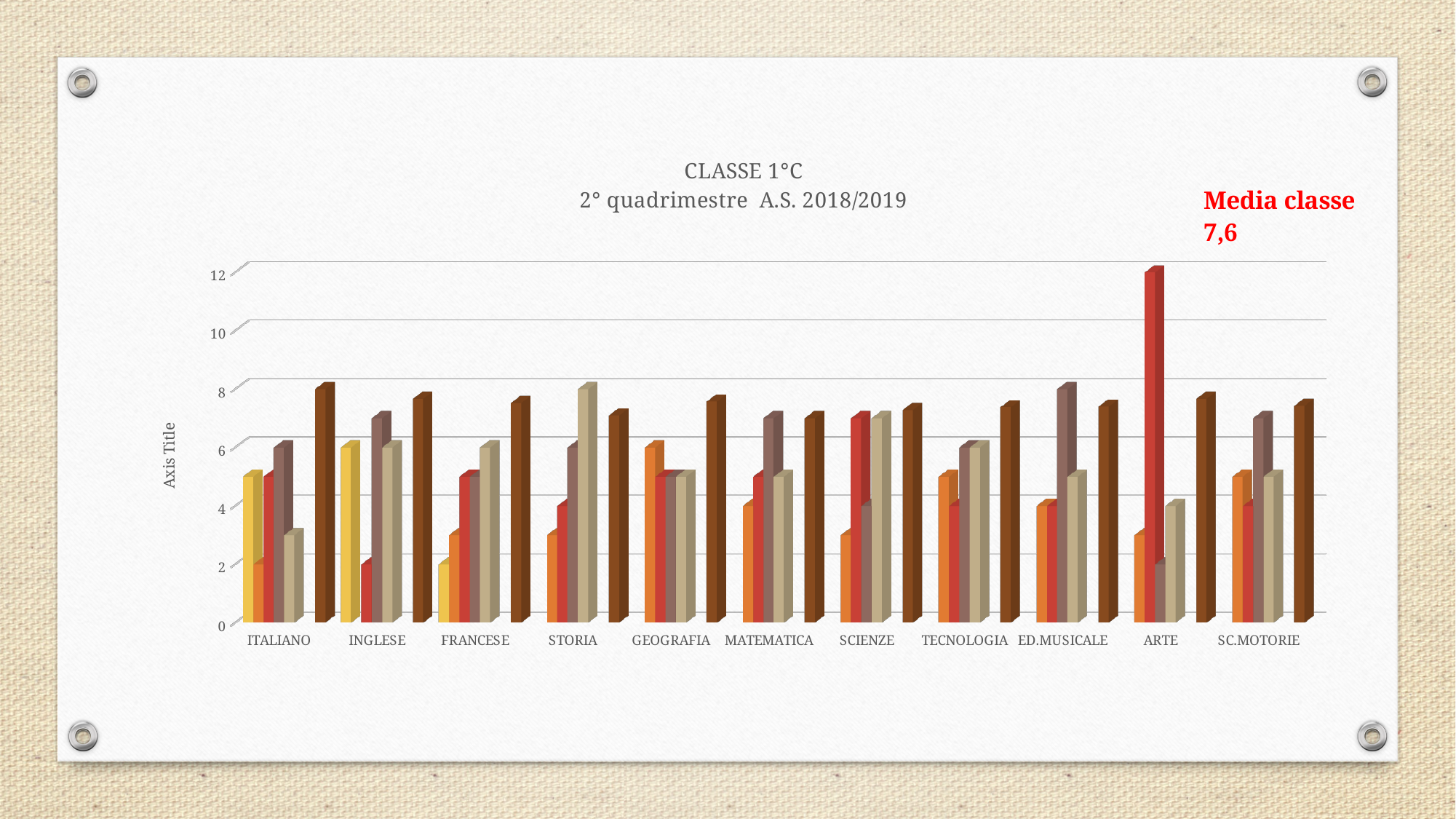
What kind of chart is shown on the slide? bar chart Is the red bar for INGLESE greater or less than 4? less What is the label on the vertical axis of the chart? Axis Title Is the tan bar for STORIA greater or less than 6? greater What is the highest value shown on the vertical axis of the chart? 12 Which subject category contains the tallest bar in the chart? ARTE Is the dark brown bar (rightmost in the group) for ITALIANO greater or less than 6? greater How many subject categories are shown along the x axis of the chart? 11 What is the title of the chart? CLASSE 1°C 2° quadrimestre A.S. 2018/2019 Which is taller in the ARTE category: the red bar or the tan bar? the red bar